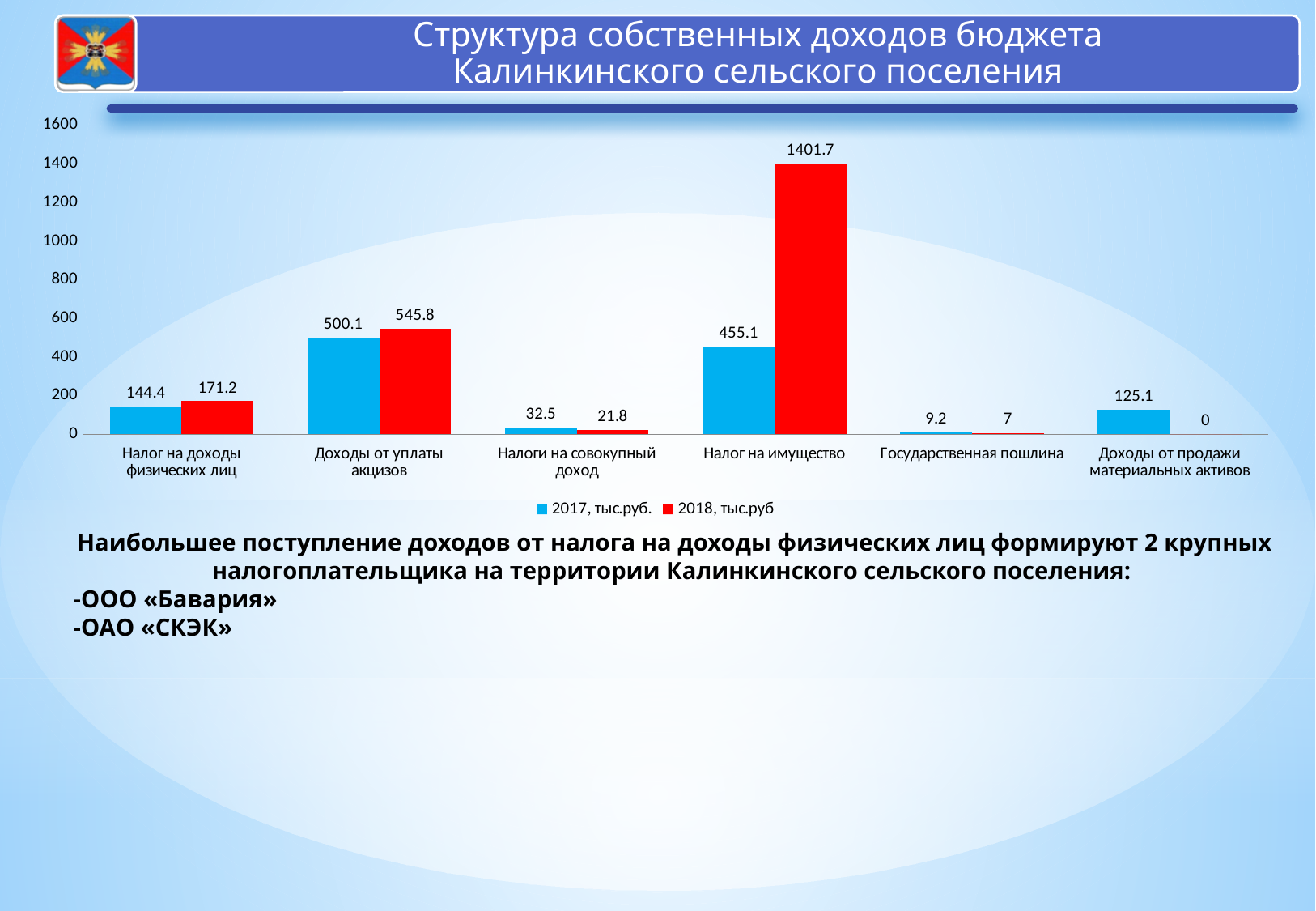
What is the 2018 value for Налог на имущество? 1401.7 How many series does the legend list? 2 Which category has the highest 2018 value? Налог на имущество Which is larger for Налоги на совокупный доход: the 2017 value or the 2018 value? 2017 Which category has the lowest 2017 value? Государственная пошлина What is the difference between the 2018 and 2017 values for Налог на доходы физических лиц? 26.8 What is the 2018 value for Государственная пошлина? 7 How many categories are shown on the x axis? 6 What colour are the bars for the 2018 series? Red What is the 2017 value for Доходы от уплаты акцизов? 500.1 What kind of chart is shown on the slide? Bar chart What is the 2017 value for Доходы от продажи материальных активов? 125.1